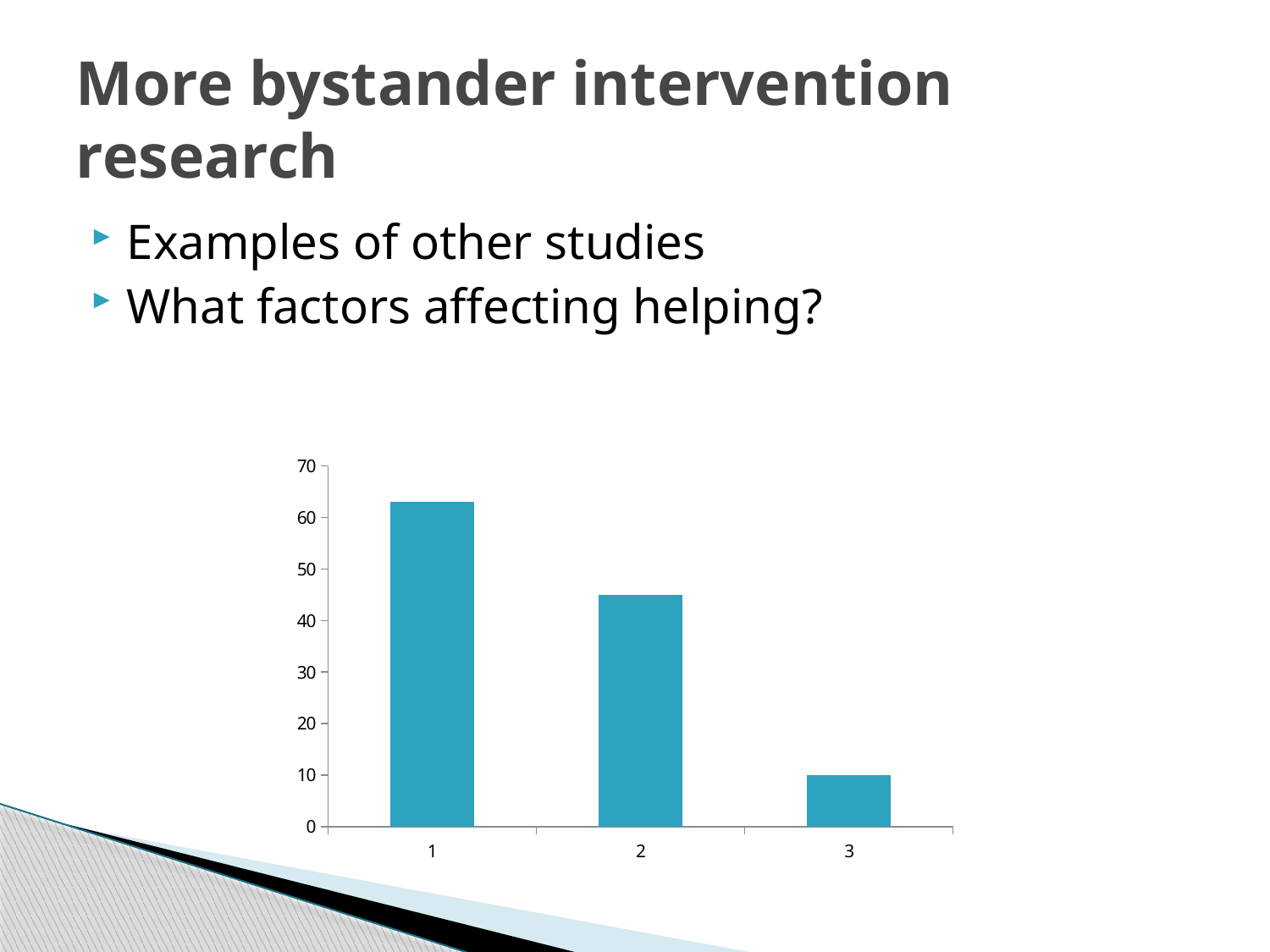
Is the value for category 1 greater or less than 60? greater Is the value for category 1 greater or less than 70? less Which category has the lowest bar? 3 Do the values rise or fall from category 1 to category 3? fall What kind of chart is shown on the slide? bar chart How many bars does the chart show? 3 Which category has the highest bar? 1 Is the value for category 2 greater or less than 50? less Which is larger, the value for category 1 or the value for category 2? category 1 What is the highest value shown on the vertical axis? 70 What is the value for category 3? 10